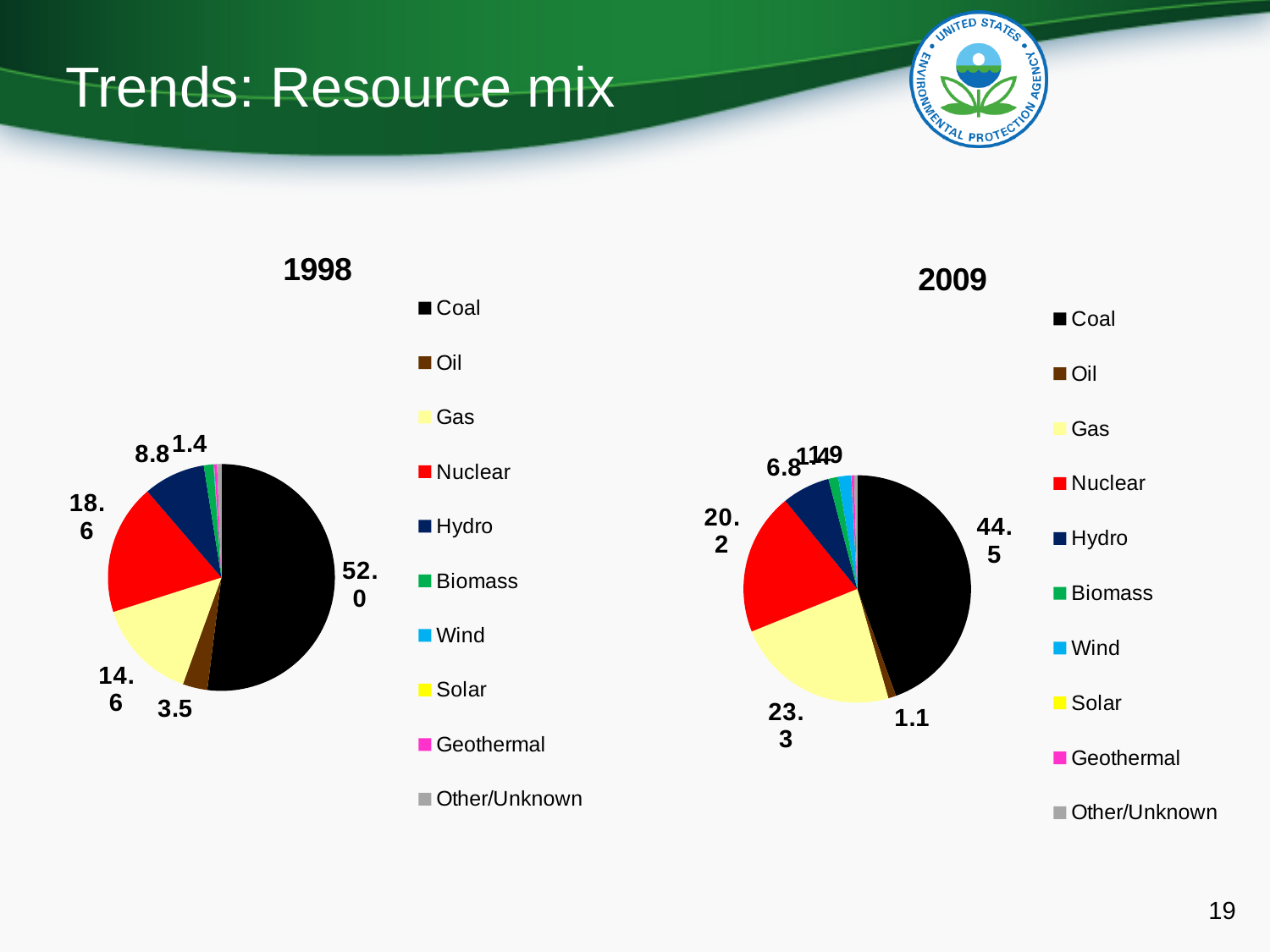
In the 2009 pie chart, what is the value shown for Gas? 23.3 What type of chart is used to show the 2009 resource mix? Pie chart Is the Gas slice larger in the 1998 pie chart or the 2009 pie chart? 2009 In the 2009 pie chart, what is the value shown for Coal? 44.5 In the 1998 chart's legend, what colour represents Coal? Black In the 2009 pie chart, what is the value shown for Oil? 1.1 By how much did the Coal value fall from the 1998 pie chart to the 2009 pie chart? 7.5 In the 1998 pie chart, what is the value shown for Nuclear? 18.6 In the 1998 pie chart, what is the value shown for Coal? 52.0 How many entries does the legend of the 1998 pie chart list? 10 In the 1998 pie chart, what is the value shown for Hydro? 8.8 In the 2009 pie chart, which resource has the largest slice? Coal